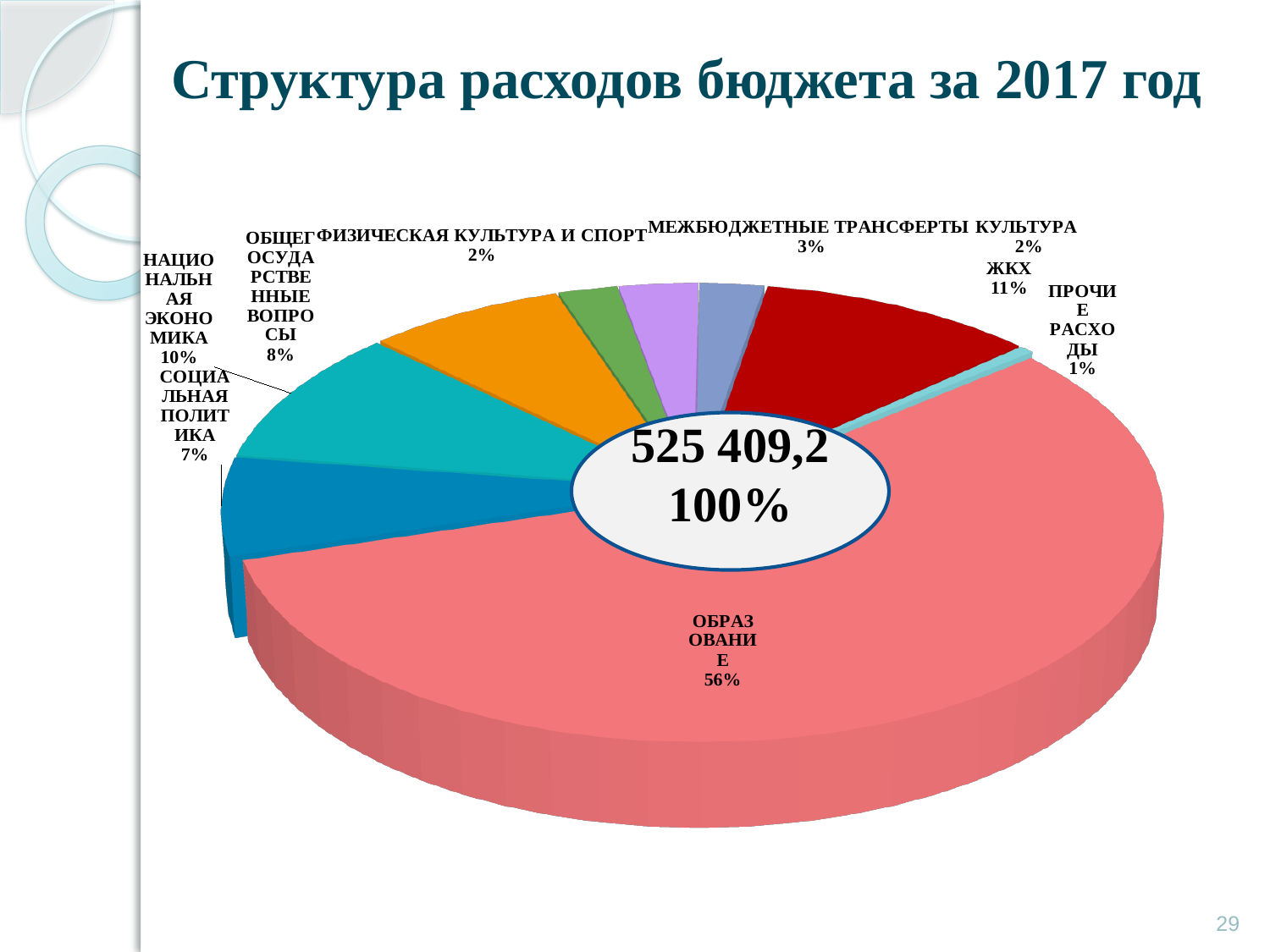
What share of the budget expenditure goes to ЖКХ? 11% What share of the budget expenditure goes to НАЦИОНАЛЬНАЯ ЭКОНОМИКА? 10% What share of the budget expenditure goes to СОЦИАЛЬНАЯ ПОЛИТИКА? 7% Which category has the smallest share of the budget expenditure? ПРОЧИЕ РАСХОДЫ Which category has the largest share of the budget expenditure? ОБРАЗОВАНИЕ What is the difference in percentage points between the shares of ЖКХ and СОЦИАЛЬНАЯ ПОЛИТИКА? 4 What kind of chart is shown on the slide? pie chart What total value is shown in the centre of the pie chart? 525 409,2 Which has a larger share, НАЦИОНАЛЬНАЯ ЭКОНОМИКА or ОБЩЕГОСУДАРСТВЕННЫЕ ВОПРОСЫ? НАЦИОНАЛЬНАЯ ЭКОНОМИКА